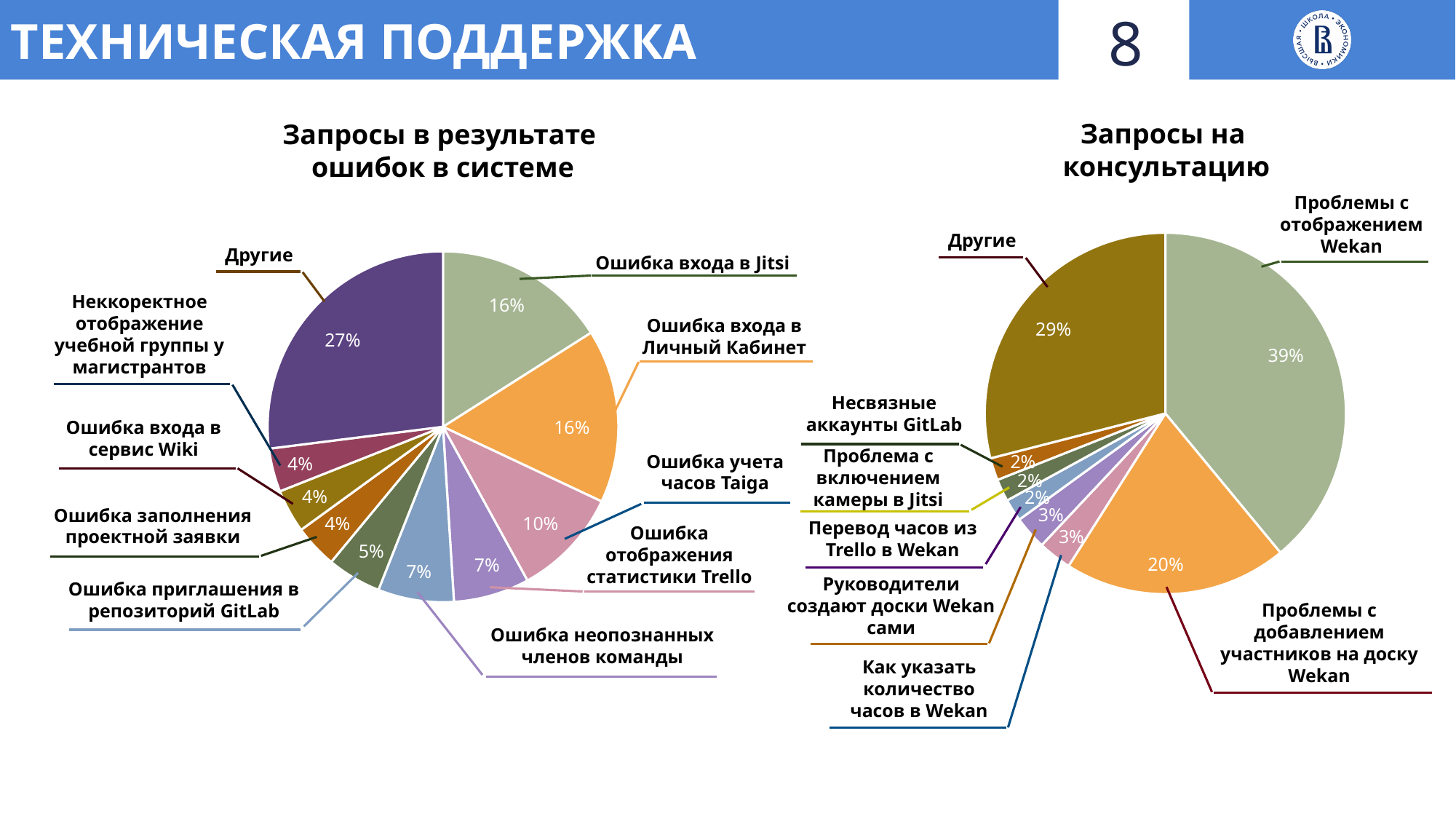
In the "Запросы на консультацию" chart, what share is "Проблемы с добавлением участников на доску Wekan"? 20% In the "Запросы в результате ошибок в системе" chart, what is the difference between "Ошибка входа в Jitsi" and "Ошибка учета часов Taiga"? 6% In the "Запросы в результате ошибок в системе" chart, what share is "Другие"? 27% In the "Запросы в результате ошибок в системе" chart, what share is "Ошибка учета часов Taiga"? 10% What kind of chart is used for "Запросы в результате ошибок в системе"? pie chart In the "Запросы на консультацию" chart, how many slices are there? 8 In the "Запросы на консультацию" chart, which category has the largest share? Проблемы с отображением Wekan In the "Запросы на консультацию" chart, what share is "Другие"? 29% In the "Запросы в результате ошибок в системе" chart, how many slices are there? 10 In the "Запросы на консультацию" chart, which is larger: "Другие" or "Проблемы с добавлением участников на доску Wekan"? Другие In the "Запросы в результате ошибок в системе" chart, what share is "Ошибка приглашения в репозиторий GitLab"? 5% In the "Запросы в результате ошибок в системе" chart, what share is "Ошибка входа в сервис Wiki"? 4%